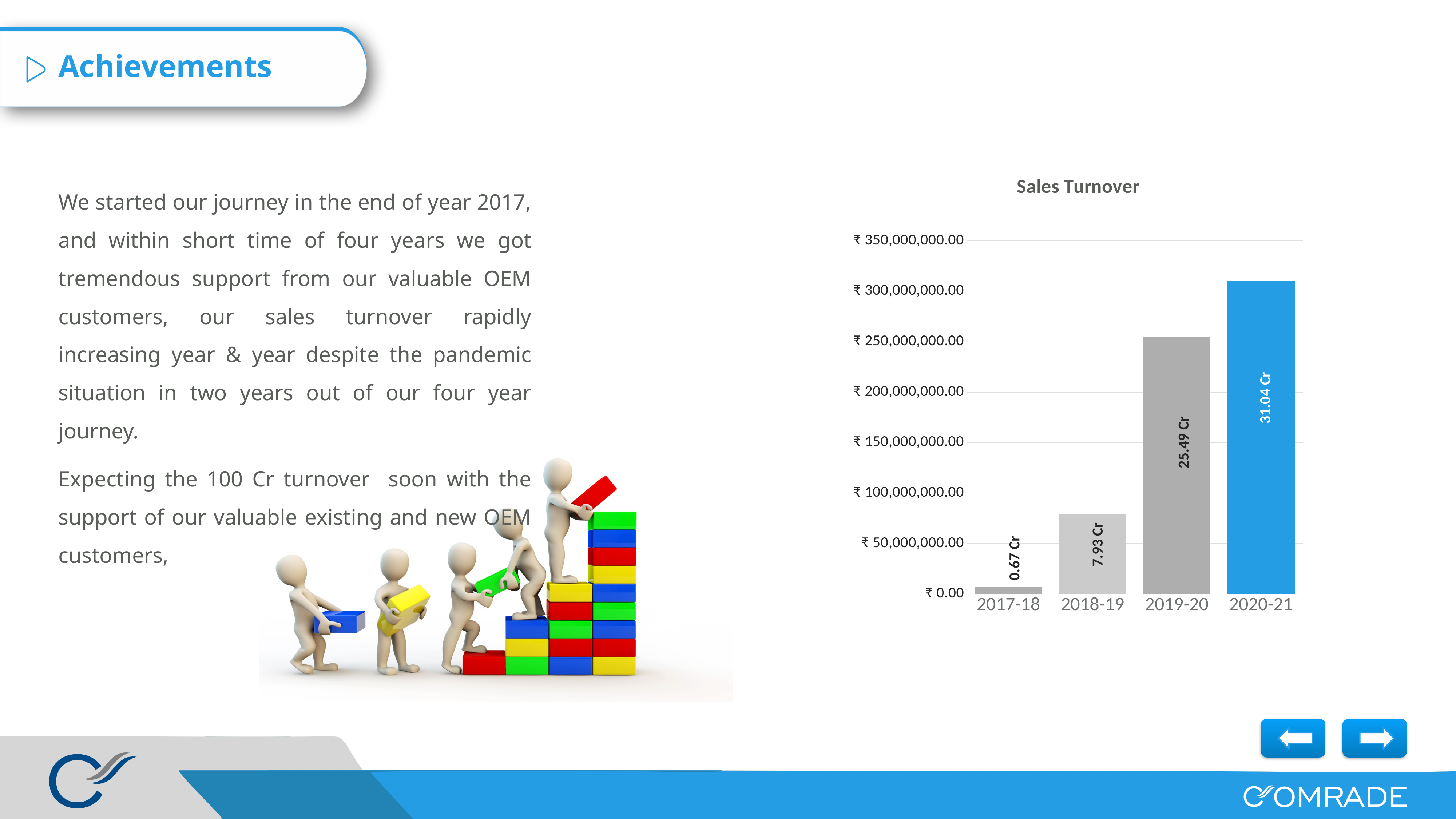
What is the value for 2019-20 in the Sales Turnover chart? 25.49 Cr What is the value for 2020-21 in the Sales Turnover chart? 31.04 Cr Which year has the lowest sales turnover in the chart? 2017-18 Is the value for 2020-21 greater or less than ₹ 300,000,000.00? greater What is the value for 2018-19 in the Sales Turnover chart? 7.93 Cr How many years are shown on the x axis of the Sales Turnover chart? 4 What is the value for 2017-18 in the Sales Turnover chart? 0.67 Cr Which is larger, the sales turnover for 2018-19 or 2019-20? 2019-20 What is the difference between the sales turnover for 2020-21 and 2019-20? 5.55 Cr What type of chart is used to show Sales Turnover? Bar chart Which year has the highest sales turnover in the chart? 2020-21 Is the value for 2018-19 greater or less than ₹ 100,000,000.00? less